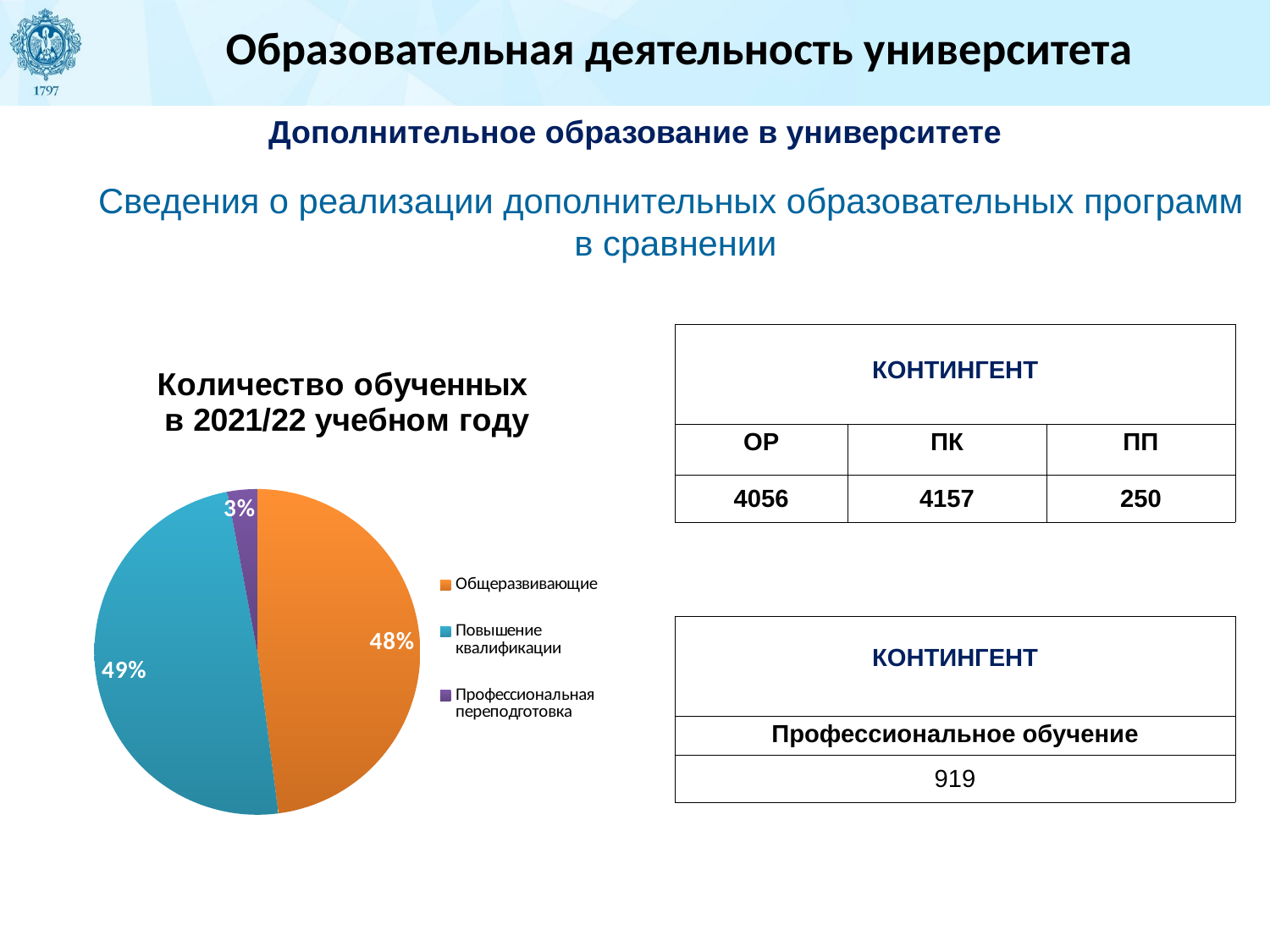
Which category has the smallest slice of the pie? Профессиональная переподготовка How many slices does the pie chart have? 3 How many entries does the legend of the pie chart list? 3 Which is larger, the share for Общеразвивающие or the share for Профессиональная переподготовка? Общеразвивающие What is the difference between the share for Общеразвивающие and the share for Профессиональная переподготовка? 45% What share of the pie does Профессиональная переподготовка have? 3% What is the title of the pie chart? Количество обученных в 2021/22 учебном году What share of the pie does Общеразвивающие have? 48% What colour is the slice for Повышение квалификации? blue What kind of chart is shown on the slide? pie chart Which category has the largest slice of the pie? Повышение квалификации What share of the pie does Повышение квалификации have? 49%